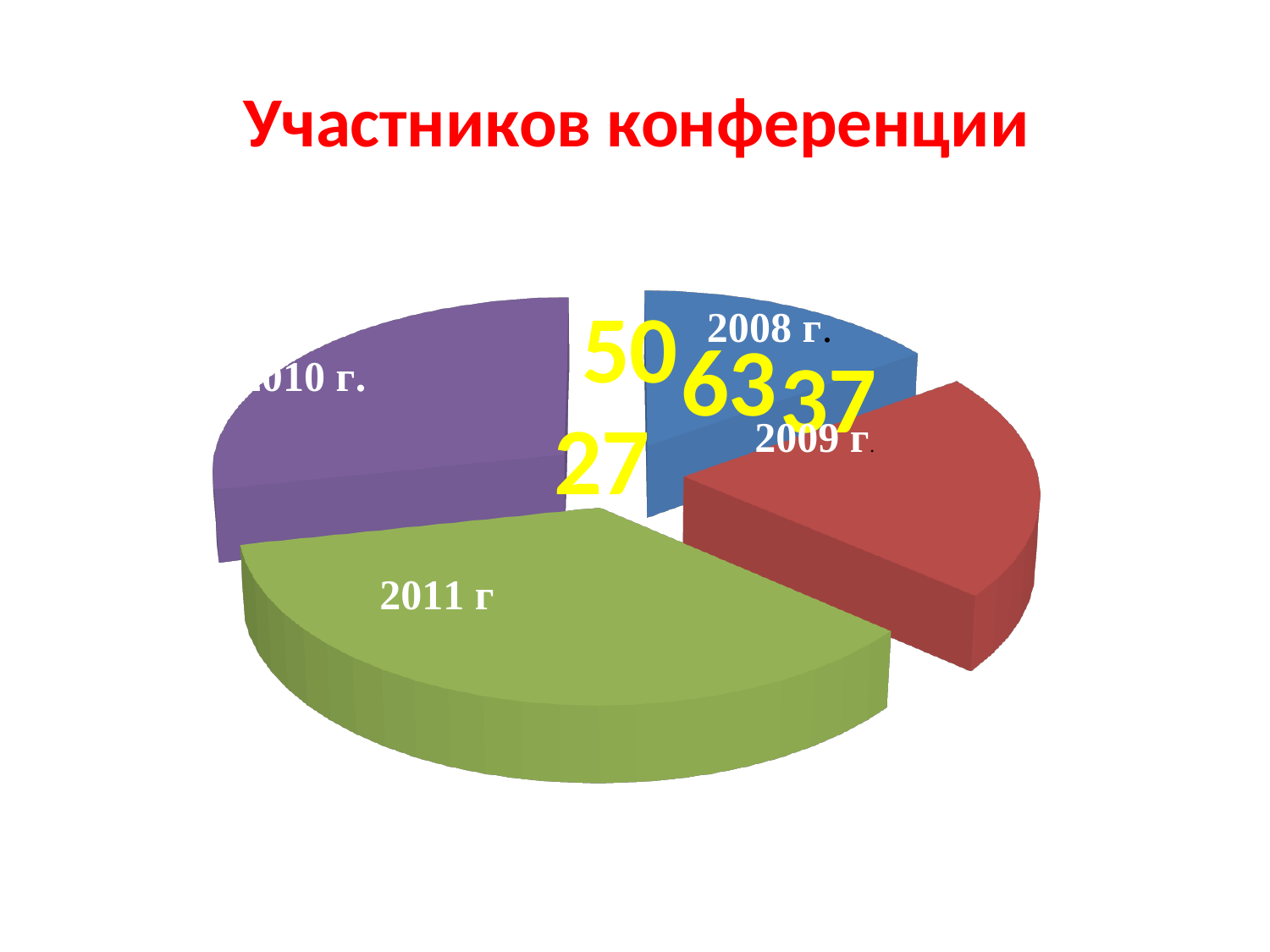
What is the title of the chart? Участников конференции Which year has the largest slice of the pie? 2011 г. What is the smallest data label value printed on the chart? 27 Which slice is larger, 2010 г. or 2008 г.? 2010 г. What is the largest data label value printed on the chart? 63 How many slices does the pie chart have? 4 Which year has the smallest slice of the pie? 2008 г. What kind of chart is shown on the slide? pie chart What colour is the slice for 2011 г.? green Which slice is larger, 2011 г. or 2009 г.? 2011 г. Which slice is larger, 2011 г. or 2008 г.? 2011 г.